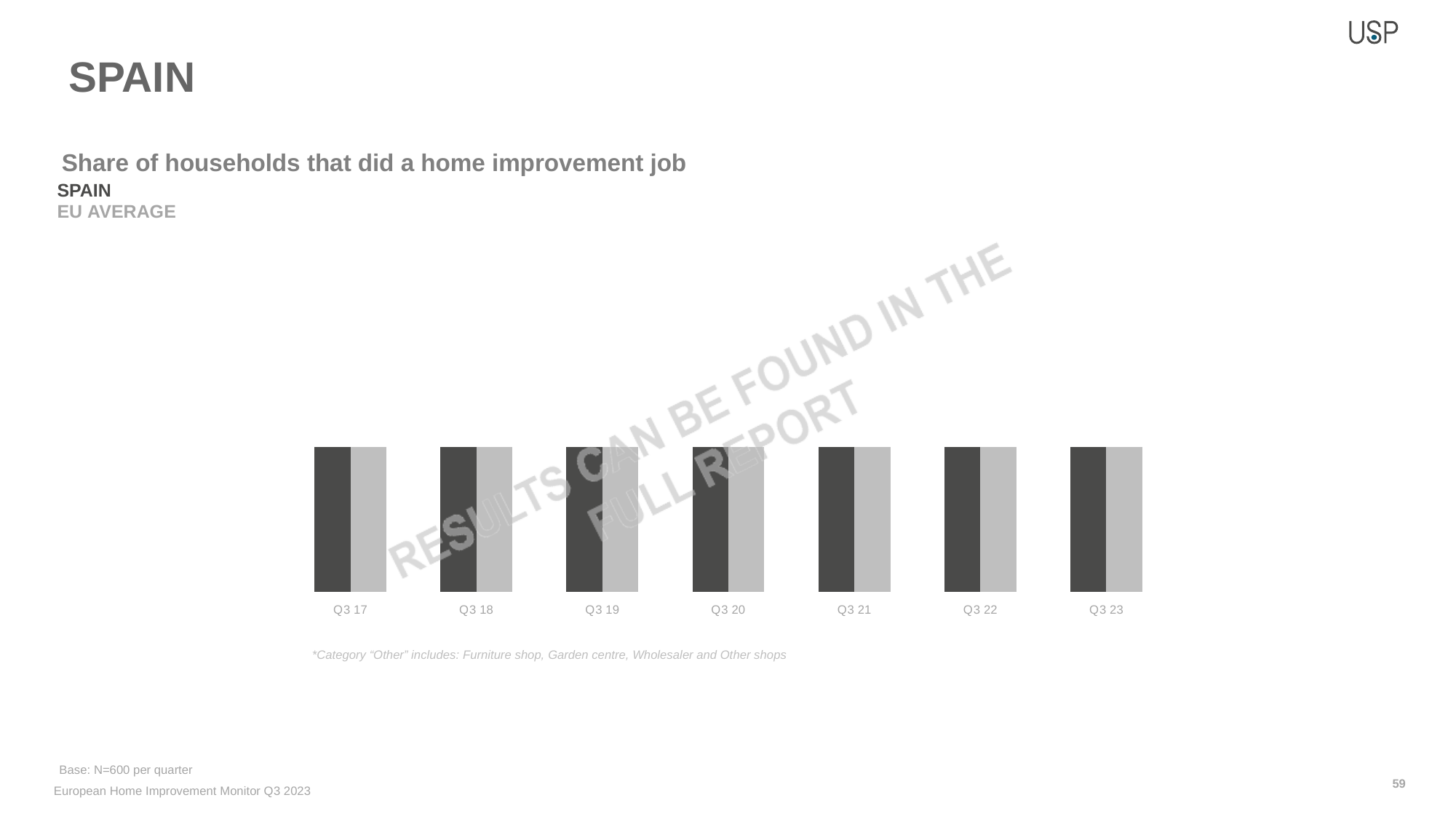
How many bars are plotted for each quarter in the chart? 2 How many series does the chart's legend list? 2 What is the title of the chart? Share of households that did a home improvement job What is the last category on the x axis of the chart? Q3 23 How many quarters are shown on the x axis of the chart? 7 What is the first category on the x axis of the chart? Q3 17 Which two series are listed in the chart's legend? SPAIN and EU AVERAGE What kind of chart is shown on the slide? bar chart